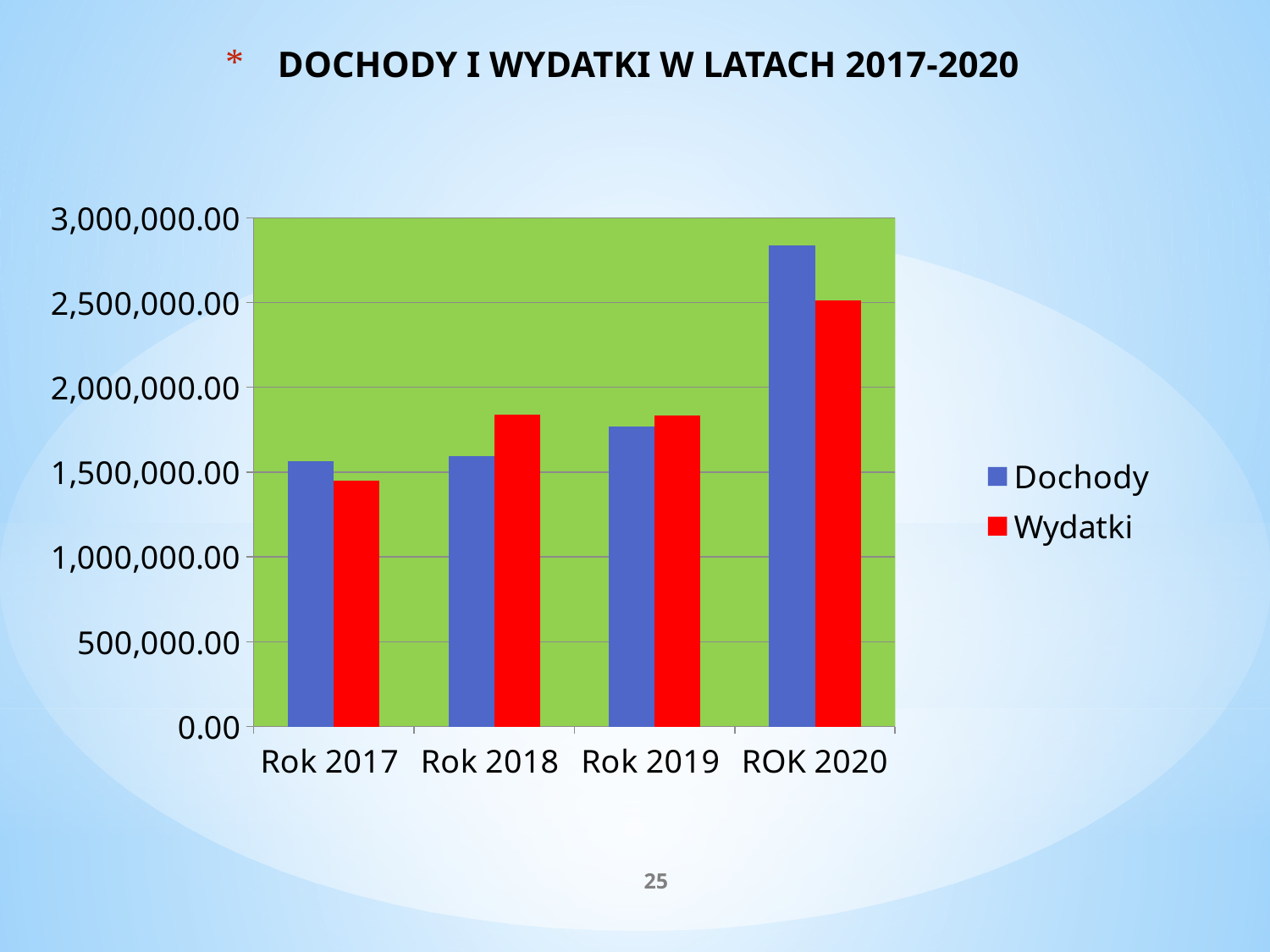
Which series are listed in the legend? Dochody and Wydatki Is the value for Wydatki in Rok 2017 greater or less than 1,500,000.00? less In Rok 2018, which is larger, Dochody or Wydatki? Wydatki In which year is Dochody the highest? ROK 2020 What is the title of the chart? DOCHODY I WYDATKI W LATACH 2017-2020 How many year categories are shown on the x axis? 4 In Rok 2017, which is larger, Dochody or Wydatki? Dochody What kind of chart is shown on the slide? Bar chart Is the value for Dochody in ROK 2020 greater or less than 2,500,000.00? greater In which year is Wydatki the lowest? Rok 2017 How many series does the legend list? 2 In which year is Wydatki the highest? ROK 2020